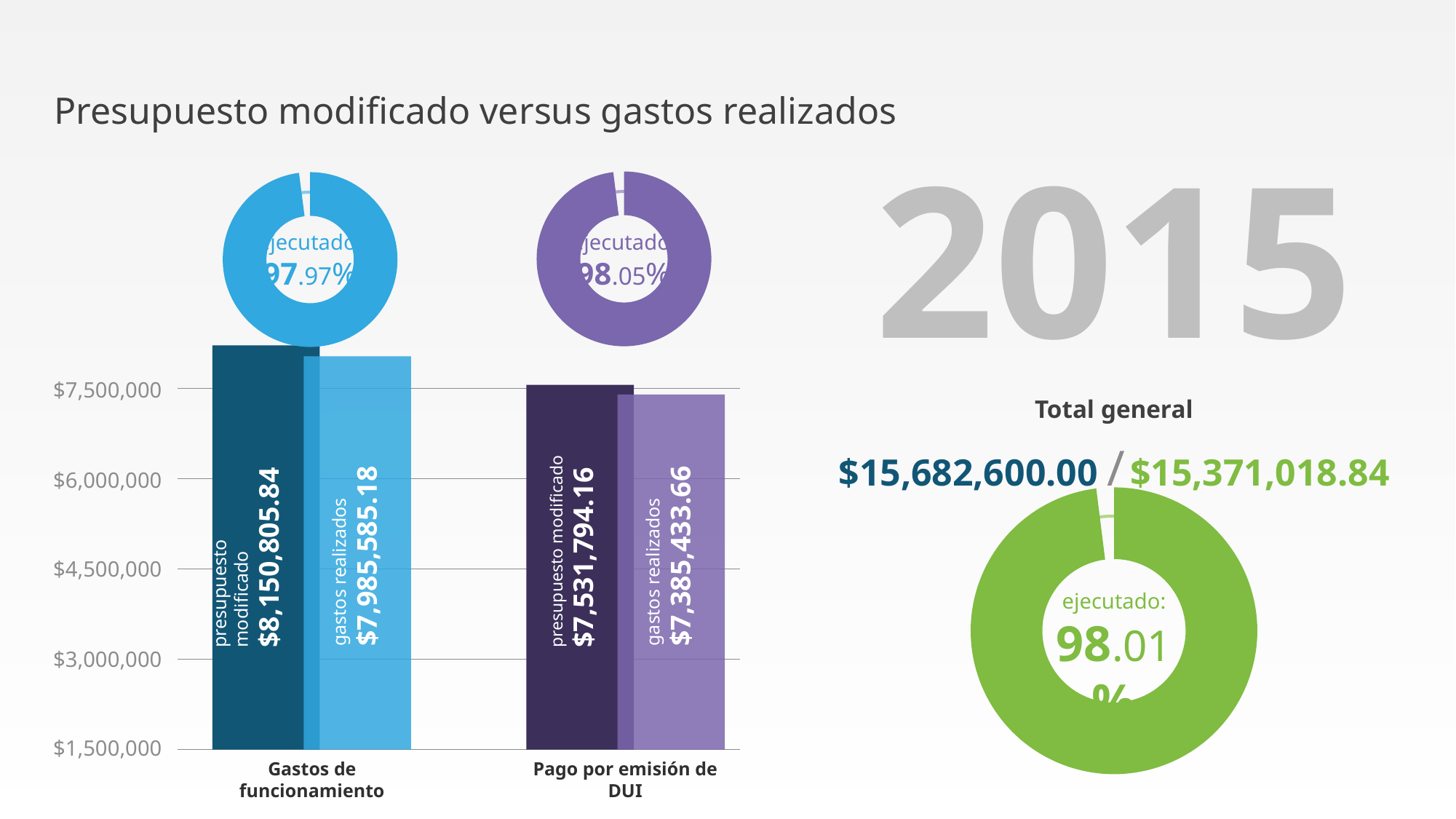
In the bar chart, what is the difference between the presupuesto modificado and the gastos realizados for Pago por emisión de DUI? $146,360.50 In the bar chart, what is the difference between the presupuesto modificado and the gastos realizados for Gastos de funcionamiento? $165,220.66 In the bar chart, what are the gastos realizados for Pago por emisión de DUI? $7,385,433.66 In the bar chart, which category has the higher presupuesto modificado, Gastos de funcionamiento or Pago por emisión de DUI? Gastos de funcionamiento In the bar chart, what is the presupuesto modificado for Gastos de funcionamiento? $8,150,805.84 In the blue donut chart above Gastos de funcionamiento, what percentage is shown as ejecutado? 97.97% What kind of chart shows the presupuesto modificado and gastos realizados values? Bar chart In the green Total general donut chart, what percentage is shown as ejecutado? 98.01% In the bar chart, how many categories are shown on the x axis? 2 In the bar chart, what are the gastos realizados for Gastos de funcionamiento? $7,985,585.18 In the bar chart, what is the presupuesto modificado for Pago por emisión de DUI? $7,531,794.16 In the purple donut chart above Pago por emisión de DUI, what percentage is shown as ejecutado? 98.05%